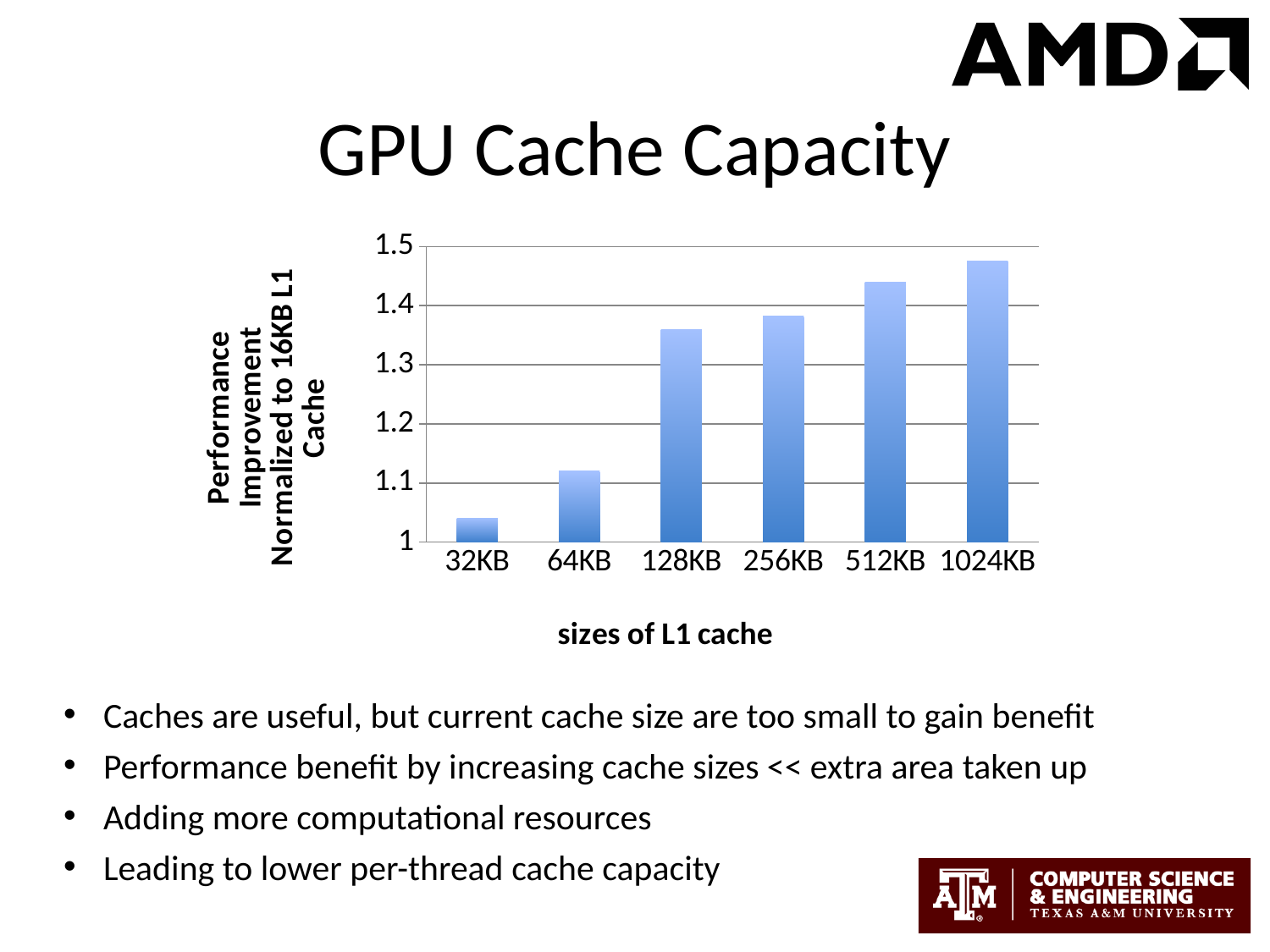
Is the value for 512KB greater or less than 1.4? greater How many cache sizes are plotted on the x axis? 6 Which cache size has the highest performance improvement? 1024KB What kind of chart is shown on the slide? bar chart Which cache size has the lowest performance improvement? 32KB Do the values rise or fall as the L1 cache size increases along the x axis? rise Which has a larger performance improvement, 64KB or 512KB? 512KB What is the x-axis title of the chart? sizes of L1 cache Is the value for 32KB greater or less than 1.1? less Is the value for 256KB greater or less than 1.4? less